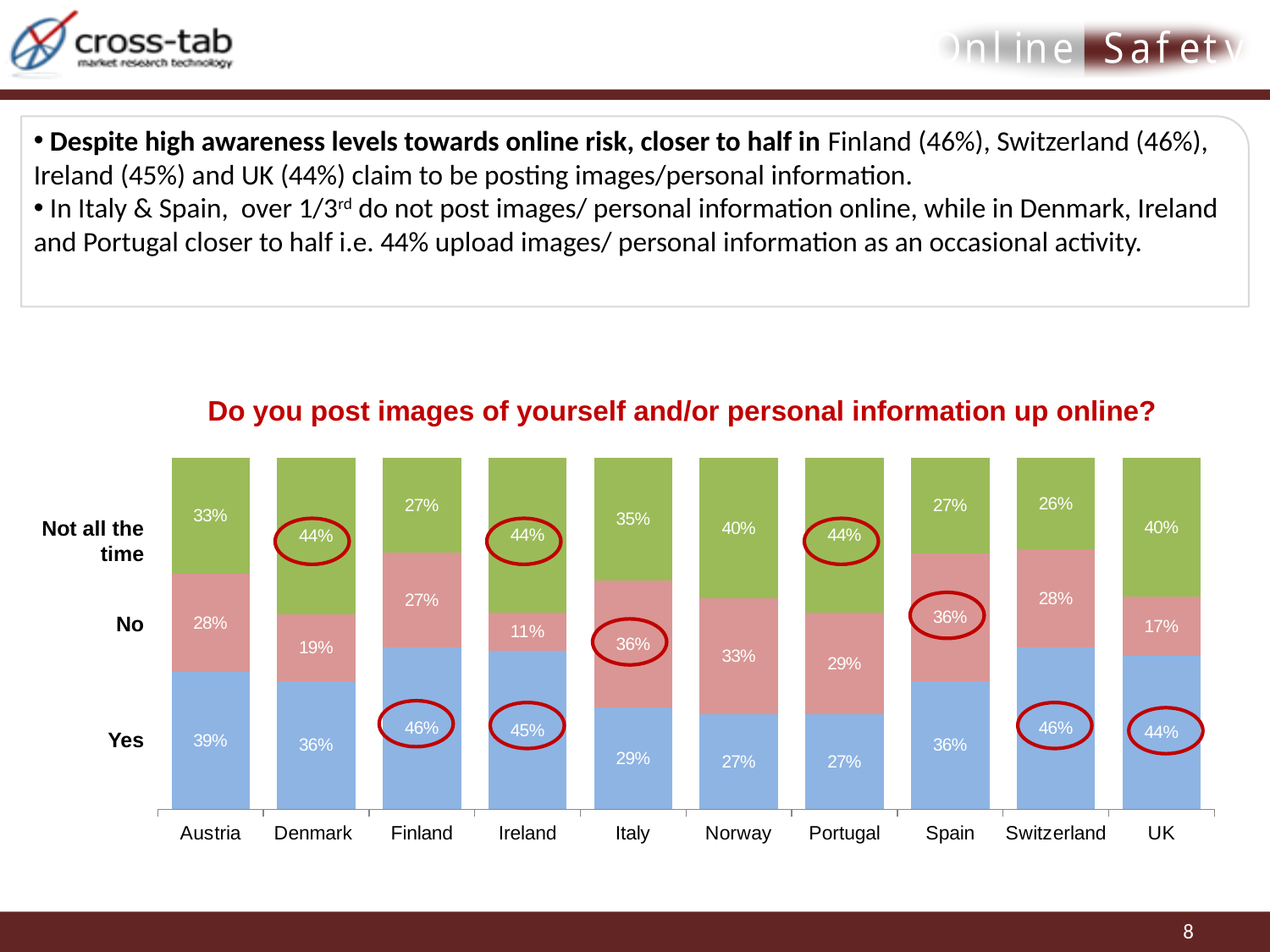
What is the "Not all the time" value for Norway? 40% What is the "No" value for Ireland in the chart? 11% What percentage of respondents in Spain answered "No"? 36% Which country has the lowest "No" value in the chart? Ireland Which is larger, the "Yes" value for Austria or the "Yes" value for Italy? Austria What is the title of the chart on the slide? Do you post images of yourself and/or personal information up online? How many countries are shown on the x axis of the chart? 10 What is the difference between the "Yes" and "No" values for the UK? 27 percentage points What type of chart is used to show the responses to "Do you post images of yourself and/or personal information up online?" Stacked bar chart What percentage of respondents in Finland answered "Yes" to posting images of themselves and/or personal information online? 46% What is the total of the three stacked segments for Austria? 100% How many response categories are stacked in each bar of the chart? 3